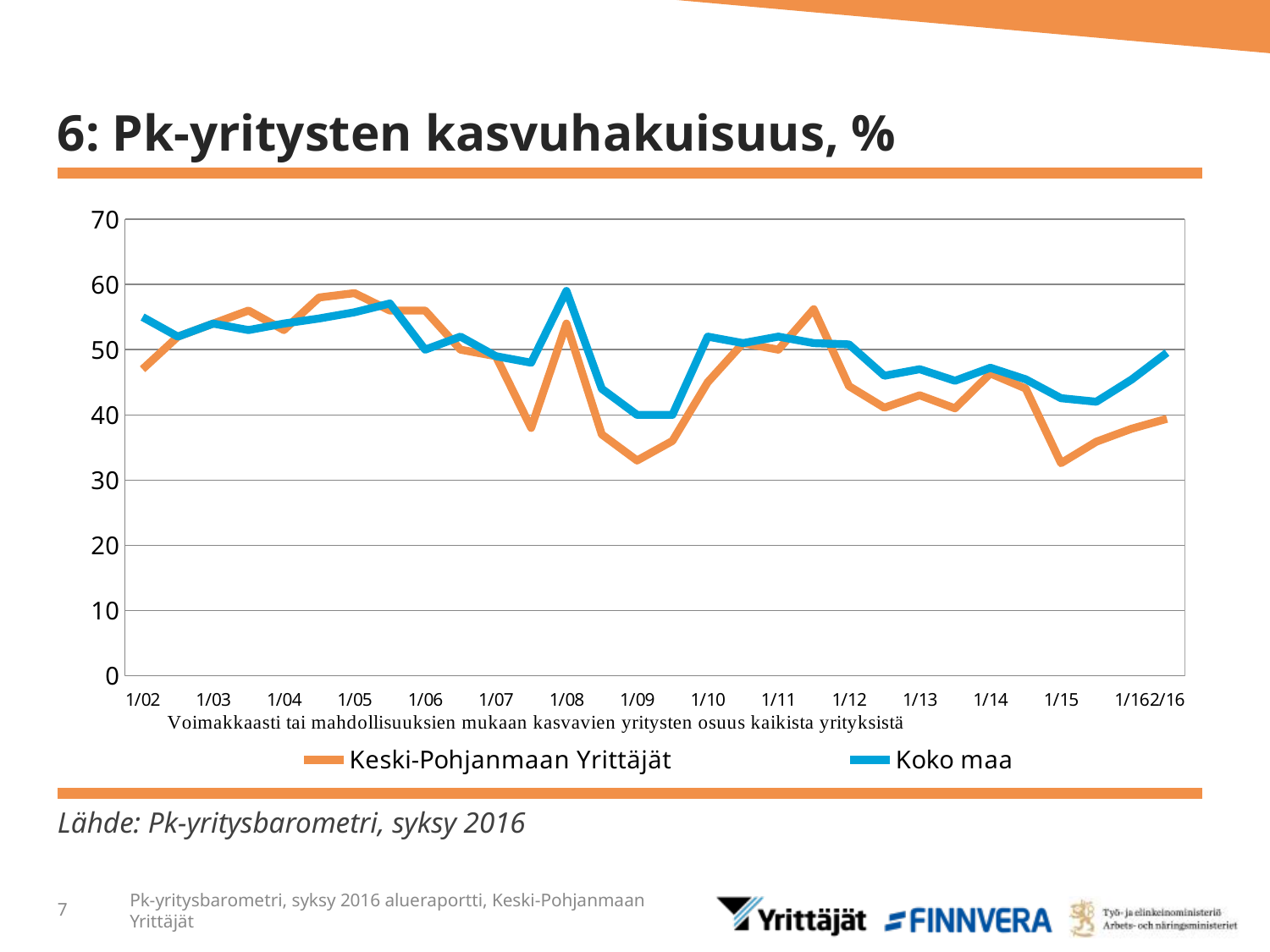
Is the value for Koko maa at 1/08 greater or less than 50? greater Which series is drawn in orange? Keski-Pohjanmaan Yrittäjät At which x-axis label does the Koko maa series reach its highest value? 1/08 At 1/08, which series has the higher value, Keski-Pohjanmaan Yrittäjät or Koko maa? Koko maa What is the title of the chart on the slide? 6: Pk-yritysten kasvuhakuisuus, % Does the Koko maa series rise or fall between 1/15 and 2/16? rise Is the value for Koko maa at 1/02 greater or less than 50? greater Is the value for Keski-Pohjanmaan Yrittäjät at 1/02 greater or less than 50? less How many series does the legend list? 2 At 1/15, which series has the higher value, Keski-Pohjanmaan Yrittäjät or Koko maa? Koko maa What kind of chart is shown on the slide? line chart